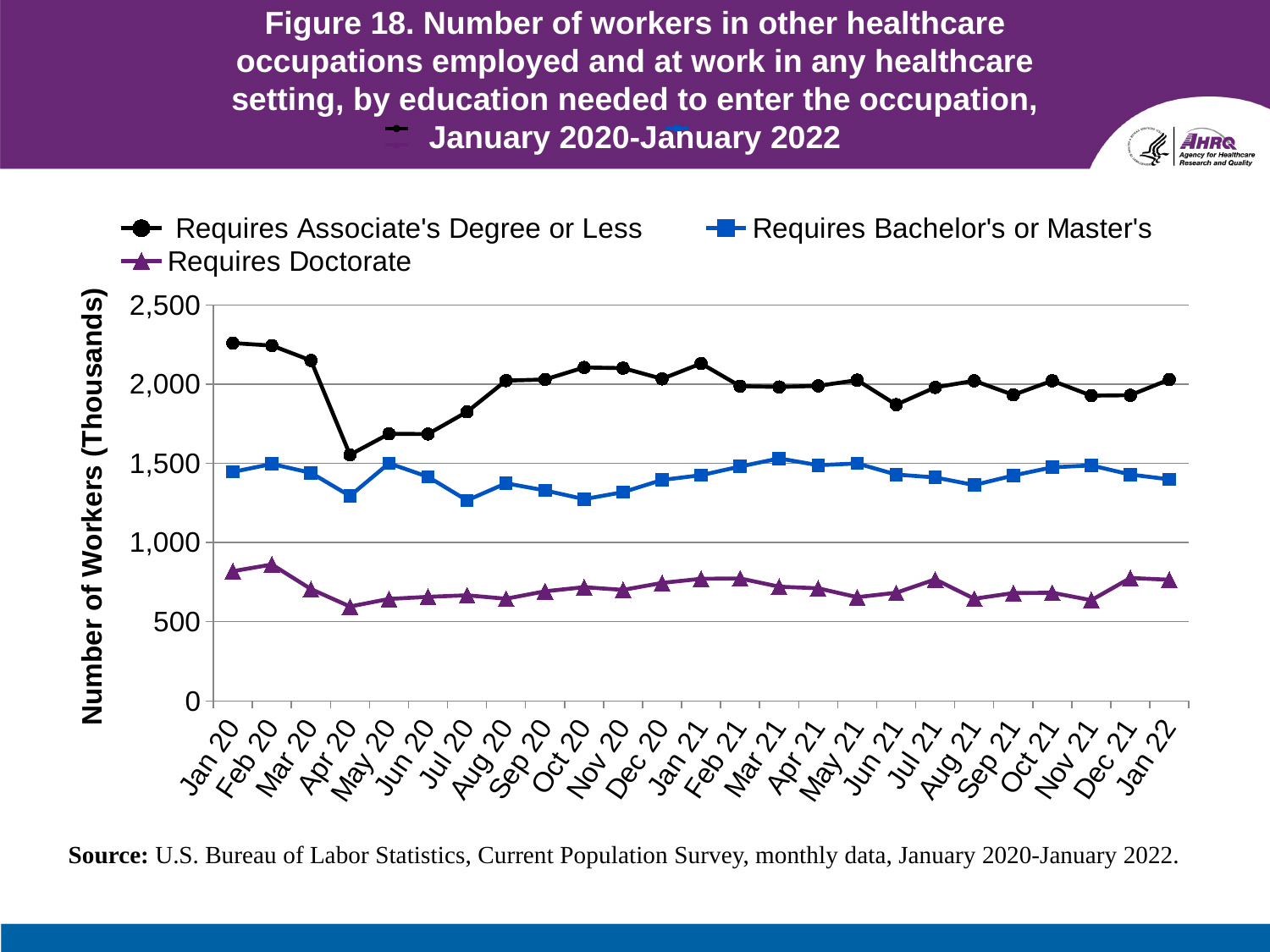
In Apr 20, which series has the larger value: 'Requires Associate's Degree or Less' or 'Requires Bachelor's or Master's'? Requires Associate's Degree or Less How many series does the legend list? 3 In which month does the 'Requires Doctorate' series reach its highest value? Feb 20 In which month does the 'Requires Associate's Degree or Less' series reach its lowest value? Apr 20 Does the 'Requires Associate's Degree or Less' series rise or fall from Jan 20 to Apr 20? Fall How many monthly data points are plotted for each series, from Jan 20 to Jan 22? 25 What kind of chart is shown on the slide? Line chart What is the title of the vertical axis? Number of Workers (Thousands) Is the value for 'Requires Doctorate' in Apr 20 greater or less than 1,000? less Is the value for 'Requires Bachelor's or Master's' in Jul 20 greater or less than 1,500? less Is the value for 'Requires Associate's Degree or Less' in Jan 20 greater or less than 2,000? greater For 'Requires Doctorate', which month has the larger value: Jan 20 or Apr 20? Jan 20